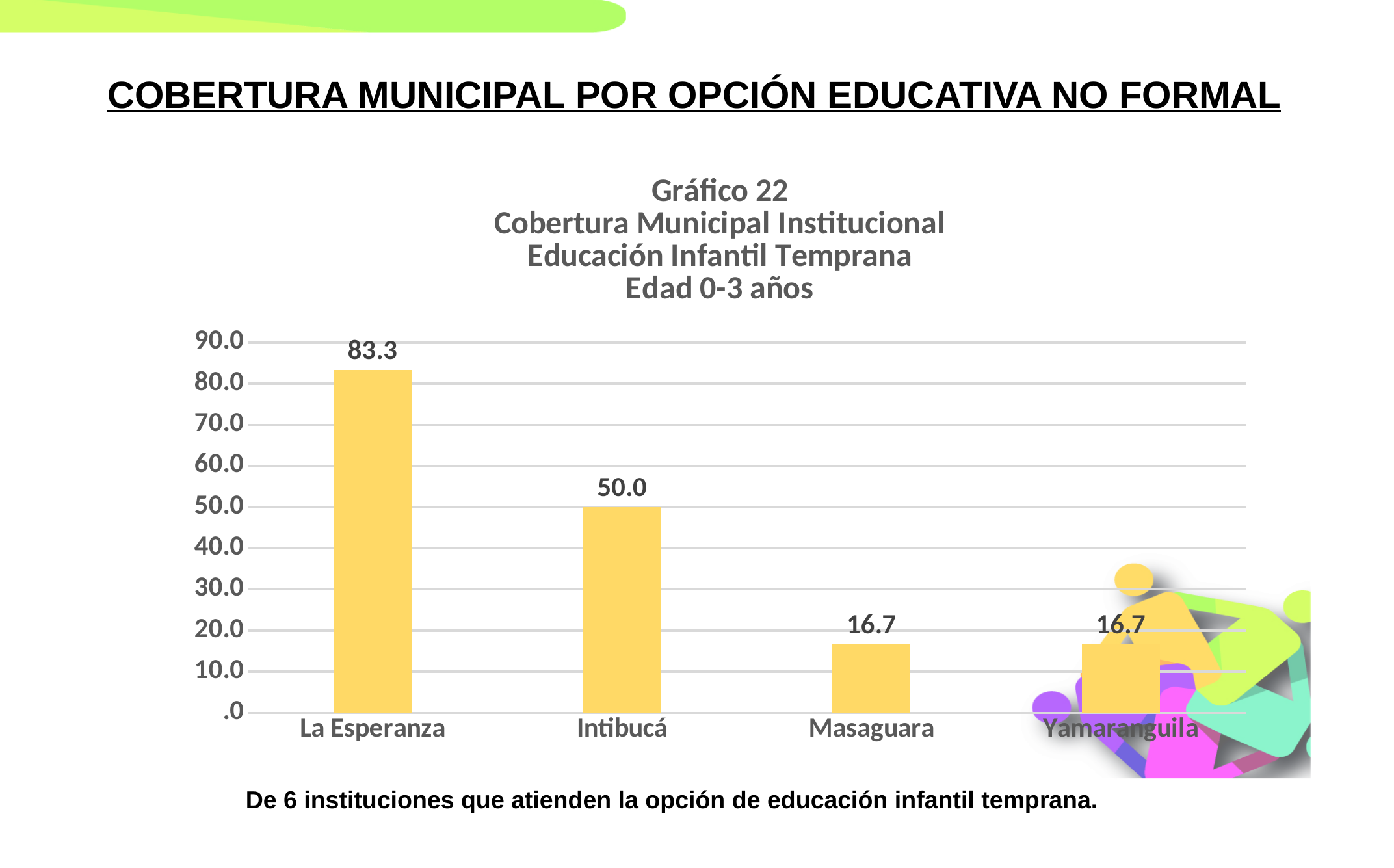
What is the difference between the values for Intibucá and Masaguara? 33.3 What kind of chart is shown on the slide? Bar chart What is the difference between the values for La Esperanza and Intibucá? 33.3 Do the values rise or fall from La Esperanza to Masaguara? Fall Which is larger, the value for Intibucá or the value for Masaguara? Intibucá Is the value for La Esperanza greater or less than 80.0? greater What is the value for Intibucá? 50.0 What is the value for Masaguara? 16.7 Which municipality has the highest value? La Esperanza How many municipalities are shown on the chart? 4 What age range is named in the chart title? 0-3 años What is the value for La Esperanza? 83.3